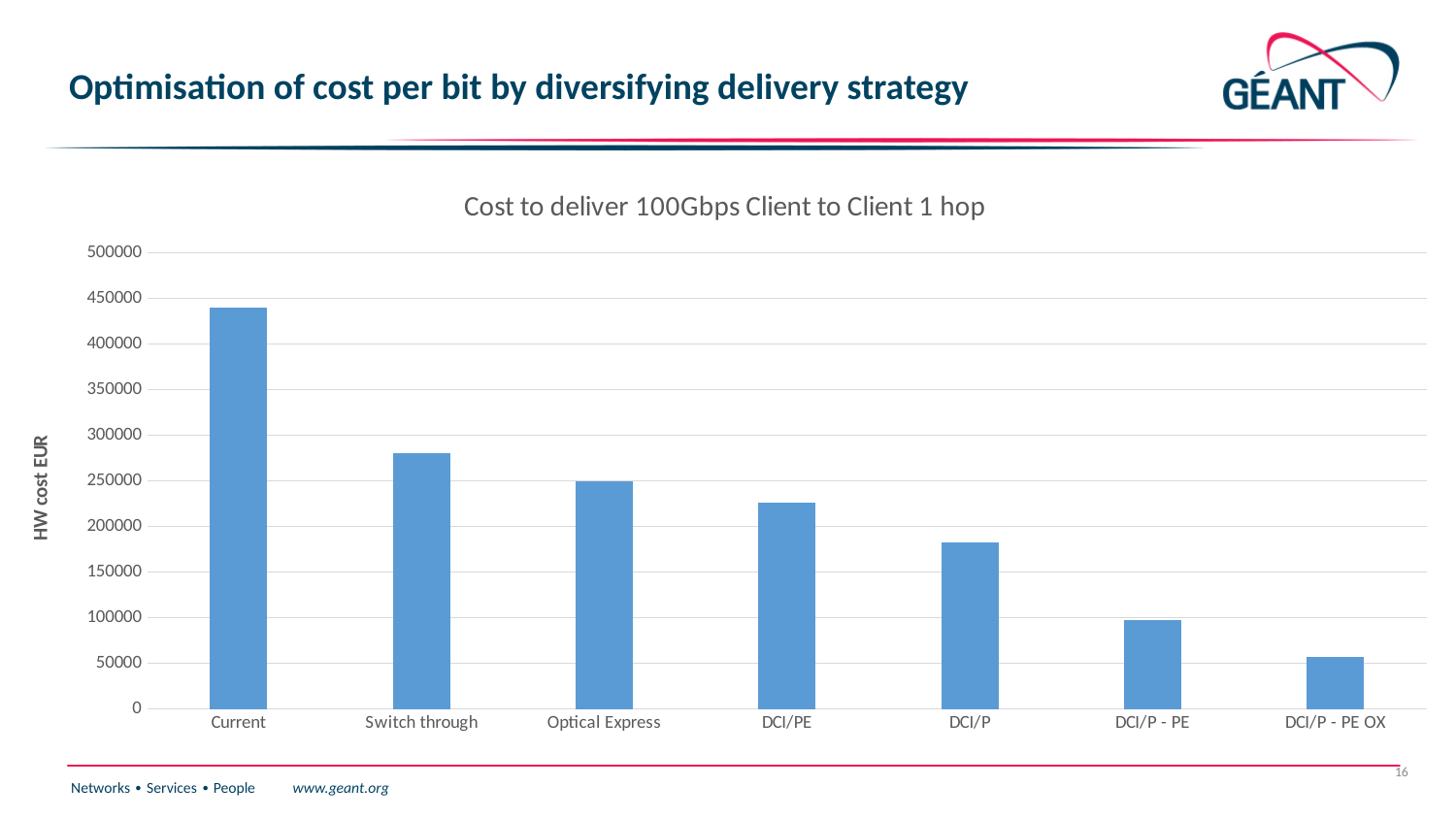
Is the value for DCI/P greater or less than 200000? less What is the label on the vertical axis of the chart? HW cost EUR What is the title of the chart? Cost to deliver 100Gbps Client to Client 1 hop Do the HW cost values rise or fall moving from left to right across the categories? fall Is the value for Switch through greater or less than 250000? greater Which has a higher HW cost, Switch through or Optical Express? Switch through What kind of chart is shown on the slide? bar chart Which delivery strategy has the lowest HW cost? DCI/P - PE OX Is the value for Current greater or less than 400000? greater Which delivery strategy has the highest HW cost? Current How many delivery strategies (categories) are plotted on the chart? 7